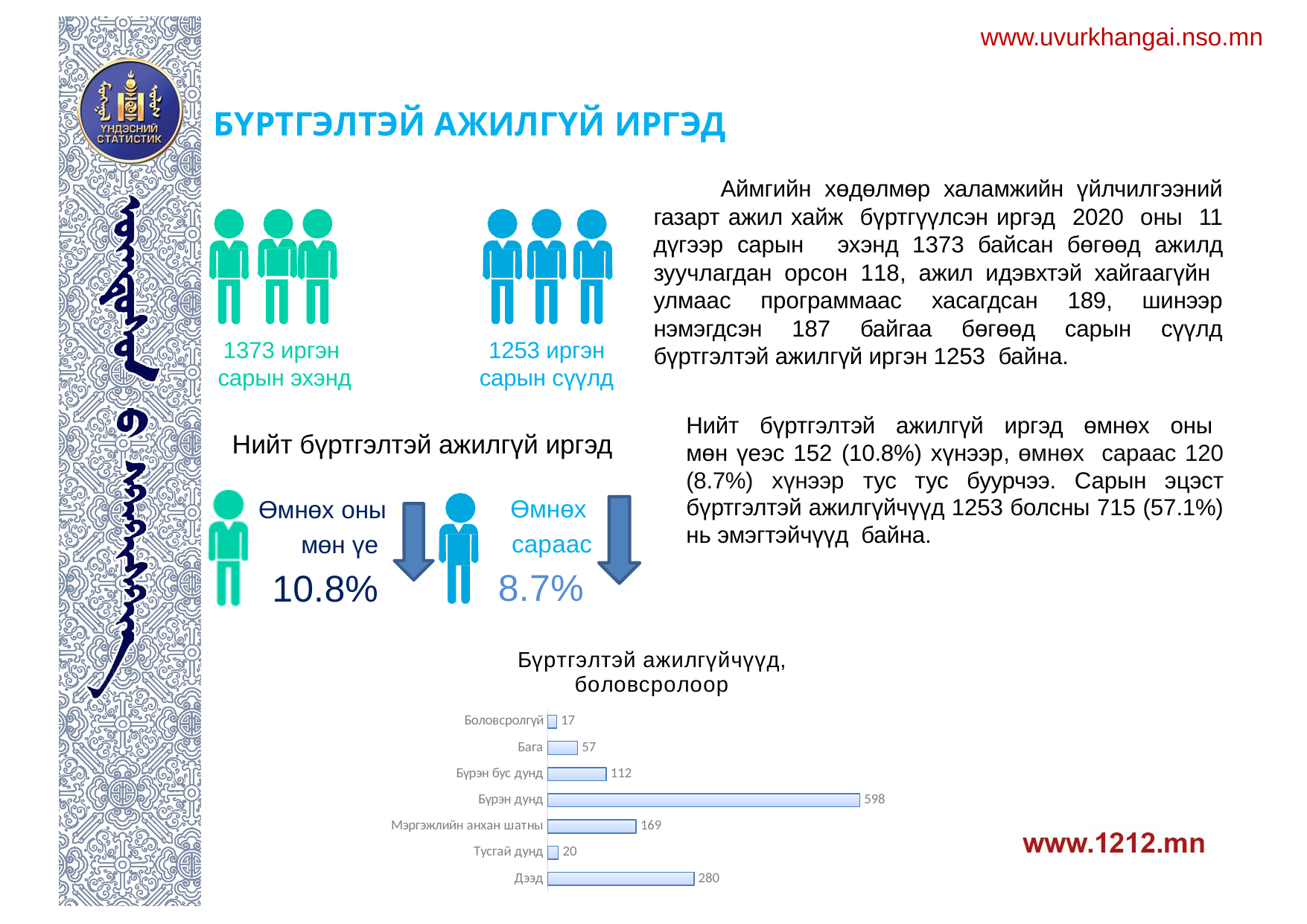
What is the difference between the values for "Бүрэн бус дунд" and "Бага"? 55 Which category has the highest value in the chart? Бүрэн дунд What is the value for "Мэргэжлийн анхан шатны" in the chart? 169 What is the value for "Дээд" in the chart? 280 What is the value for "Боловсролгүй" in the chart? 17 How many categories are shown in the chart? 7 Which category has the lowest value in the chart? Боловсролгүй What is the difference between the values for "Бүрэн дунд" and "Дээд"? 318 What is the value for "Бүрэн дунд" in the chart? 598 What type of chart is shown under the title "Бүртгэлтэй ажилгүйчүүд, боловсролоор"? Bar chart Which is larger, the value for "Тусгай дунд" or the value for "Бага"? Бага What is the title of the chart on the slide? Бүртгэлтэй ажилгүйчүүд, боловсролоор